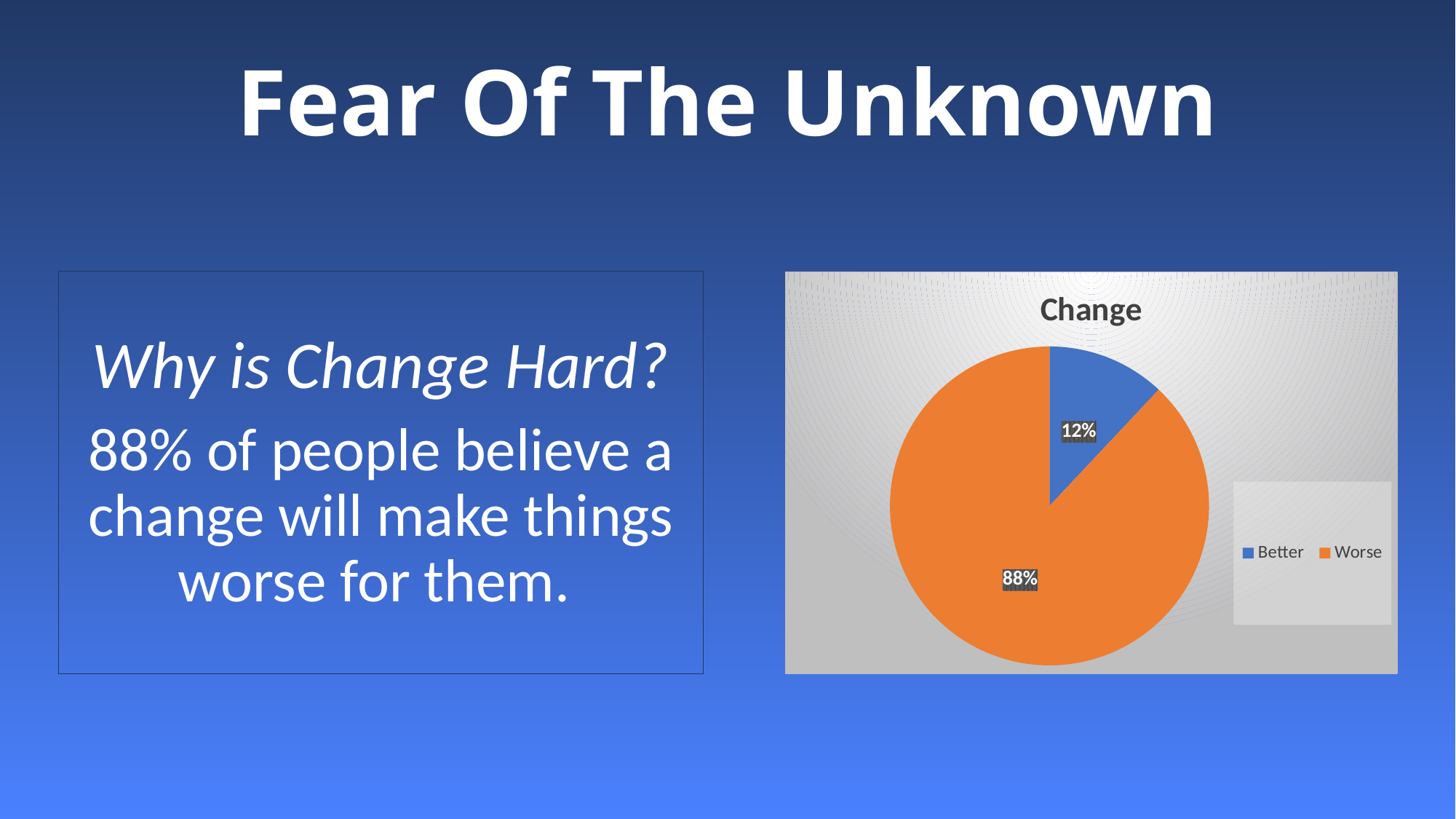
Which slice of the pie is the smallest? Better What is the difference in percentage points between the Worse and Better slices? 76 How many entries does the legend list? 2 What percentage of the pie is the Worse slice? 88% Which slice is larger, Better or Worse? Worse How many slices does the pie chart have? 2 What colour is the Worse slice? orange What share of the pie does the Better slice represent? 12% What is the title of the chart? Change What kind of chart is shown on the slide? pie chart Which slice of the pie is the largest? Worse What percentage of the pie is the Better slice? 12%